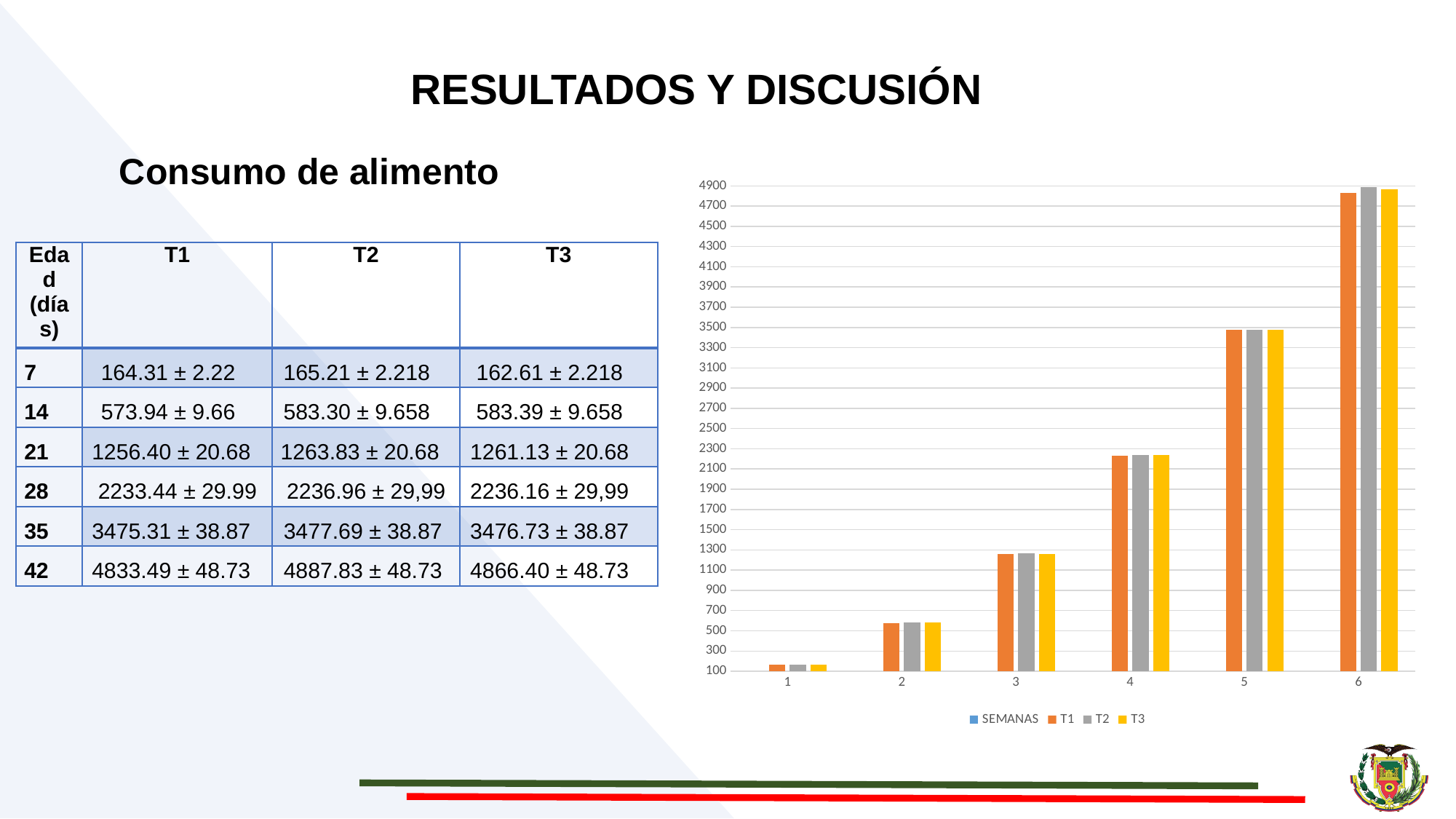
How many series does the chart legend list? 4 For which x-axis category is the T2 bar the tallest? 6 Do the T1 values rise or fall as the x axis goes from 1 to 6? rise For which x-axis category is the T3 bar the shortest? 1 Is the T2 value at category 5 greater or less than 3700? less What are the legend entries of the chart, in order? SEMANAS, T1, T2, T3 Is the T1 value at category 6 greater or less than 4500? greater Which is larger: the T1 value at category 4 or the T1 value at category 2? category 4 Is the T3 value at category 4 greater or less than 2100? greater How many categories are shown along the x axis of the chart? 6 What kind of chart is shown on the slide? bar chart